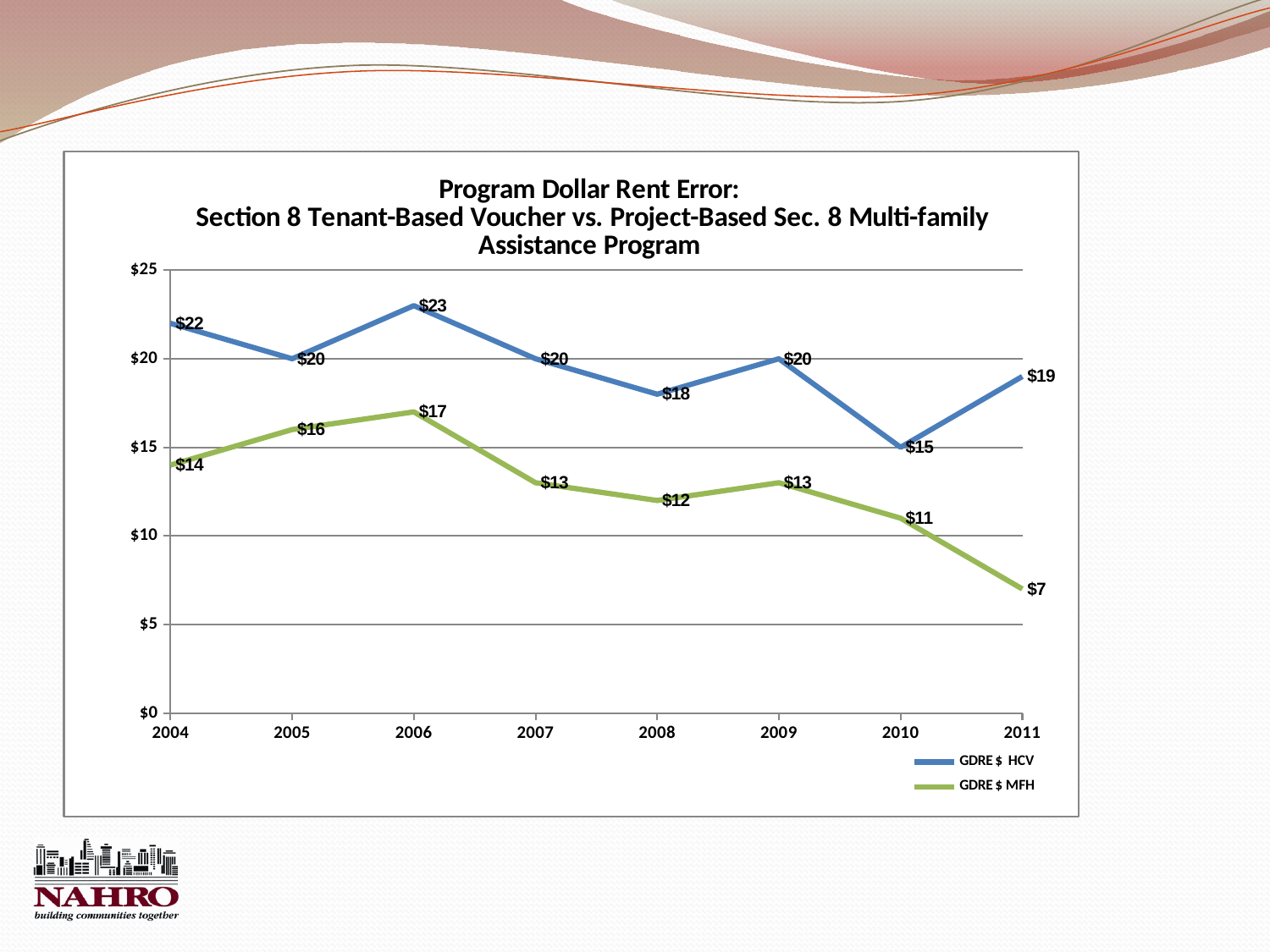
In which year is the GDRE $ MFH value highest? 2006 Which series has the larger value in 2008, GDRE $ HCV or GDRE $ MFH? GDRE $ HCV What is the difference between the GDRE $ HCV and GDRE $ MFH values in 2011? $12 What is the GDRE $ HCV value for 2010? $15 What kind of chart is shown on the slide? line chart What is the GDRE $ MFH value for 2011? $7 What is the GDRE $ HCV value for 2006? $23 How many series does the legend list? 2 Is the GDRE $ MFH value for 2010 greater or less than $15? less Does the GDRE $ MFH series rise or fall from 2009 to 2011? fall In which year is the GDRE $ HCV value lowest? 2010 How many years are shown on the x axis? 8